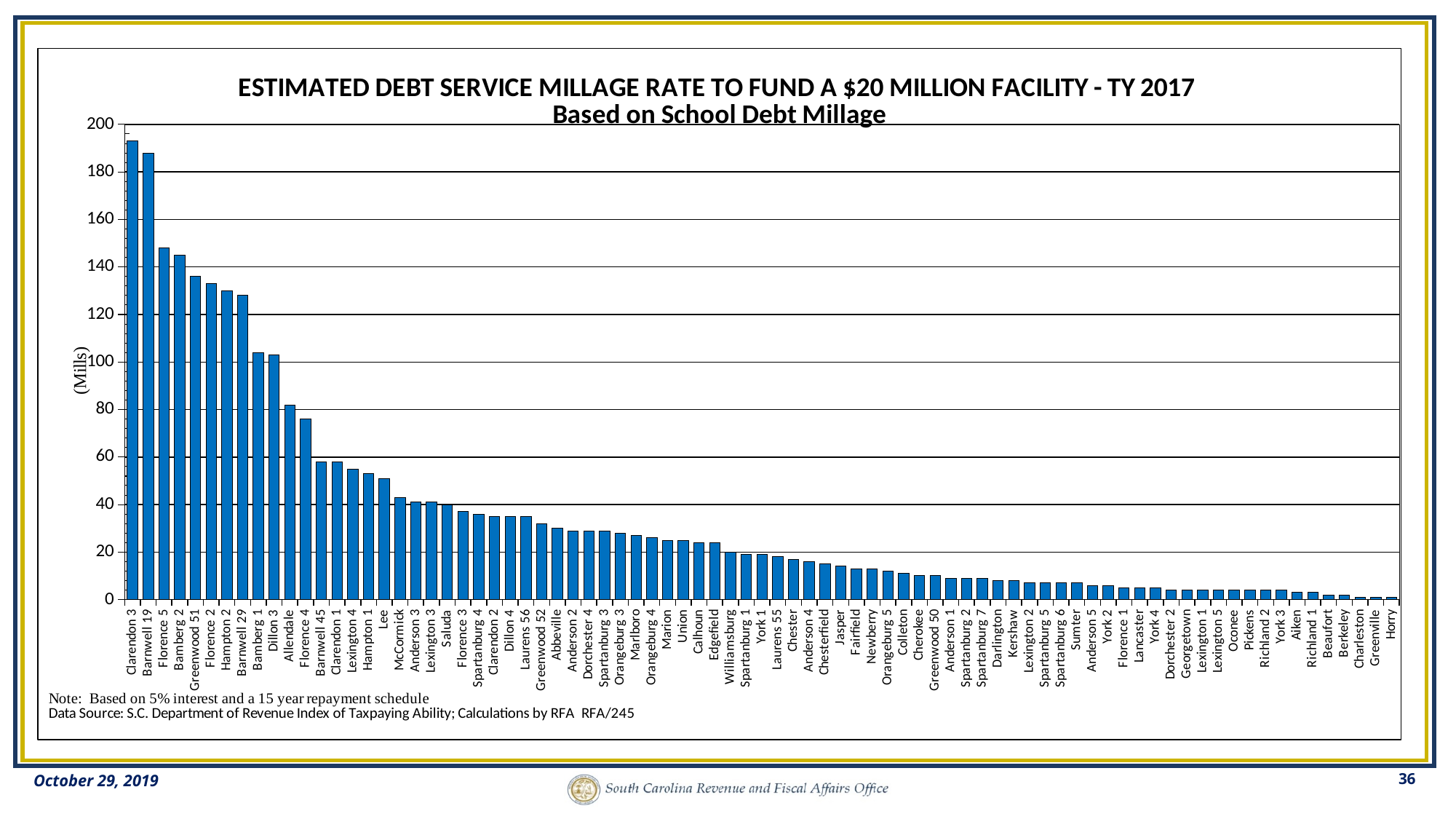
Is the value for Allendale greater or less than 100? less Is the value for Clarendon 3 greater or less than 180? greater Is the value for Horry greater or less than 20? less What kind of chart is shown on the slide? Bar chart Which has a higher value, Florence 4 or Barnwell 45? Florence 4 Do the values rise or fall moving from left to right along the x axis? Fall Which district has the highest estimated debt service millage rate? Clarendon 3 Which has a higher value, Greenwood 51 or Allendale? Greenwood 51 What unit is shown on the y axis of the chart? Mills